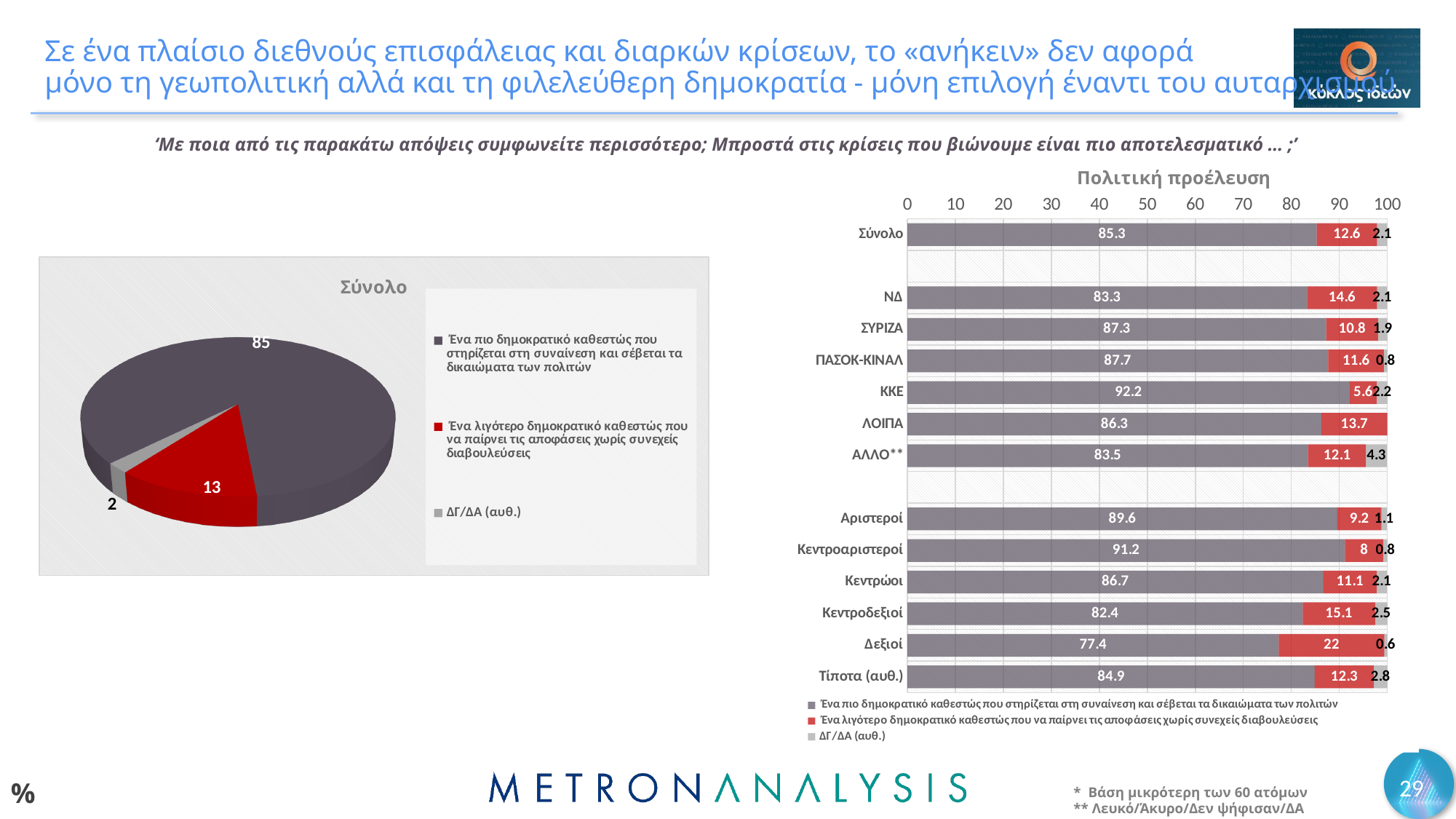
In the bar chart titled 'Πολιτική προέλευση', what is the value of the red segment ('Ένα λιγότερο δημοκρατικό καθεστώς...') for Δεξιοί? 22 In the bar chart titled 'Πολιτική προέλευση', how many series does the legend list? 3 In the pie chart titled 'Σύνολο', how many slices are there? 3 In the bar chart titled 'Πολιτική προέλευση', which is larger: the red segment for Κεντροδεξιοί or for Κεντροαριστεροί? Κεντροδεξιοί In the bar chart titled 'Πολιτική προέλευση', what is the value of the grey segment ('Ένα πιο δημοκρατικό καθεστώς...') for ΚΚΕ? 92.2 In the pie chart titled 'Σύνολο', what is the value of the red slice ('Ένα λιγότερο δημοκρατικό καθεστώς...')? 13 What kind of chart is the chart on the right titled 'Πολιτική προέλευση'? Bar chart In the pie chart titled 'Σύνολο', what share does the slice for 'Ένα πιο δημοκρατικό καθεστώς που στηρίζεται στη συναίνεση και σέβεται τα δικαιώματα των πολιτών' have? 85 In the bar chart titled 'Πολιτική προέλευση', what is the difference between the 'Ένα πιο δημοκρατικό καθεστώς...' values for ΣΥΡΙΖΑ and ΝΔ? 4 What kind of chart is the chart on the left titled 'Σύνολο'? Pie chart In the bar chart titled 'Πολιτική προέλευση', which category has the highest value for 'Ένα πιο δημοκρατικό καθεστώς...'? ΚΚΕ In the bar chart titled 'Πολιτική προέλευση', which category has the lowest value for 'Ένα πιο δημοκρατικό καθεστώς...'? Δεξιοί